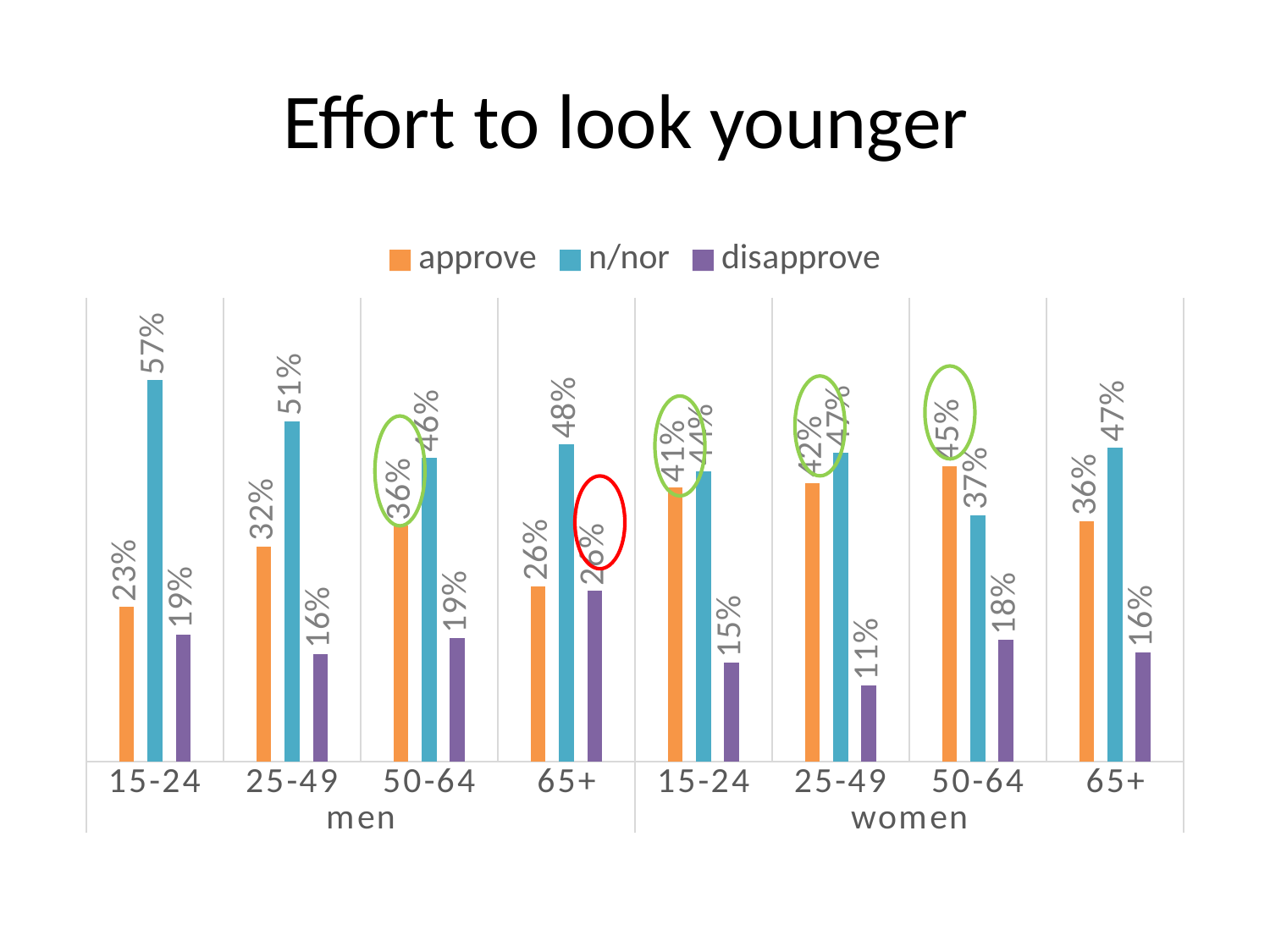
What type of chart is shown on the slide? bar chart What is the title of the chart? Effort to look younger How many series does the legend list? 3 Which group has the lowest disapprove value across the whole chart? women 25-49 Do the approve values for men rise or fall from the 15-24 group to the 50-64 group? rise What is the approve value for women aged 50-64? 45% Which age group among men has the highest approve value? 50-64 How many age groups are shown on the x axis in total? 8 What is the disapprove value for women aged 25-49? 11% Which is larger for women aged 50-64: the approve value or the n/nor value? approve What is the difference between the n/nor and approve values for men aged 15-24? 34% What is the n/nor value for men aged 15-24? 57%